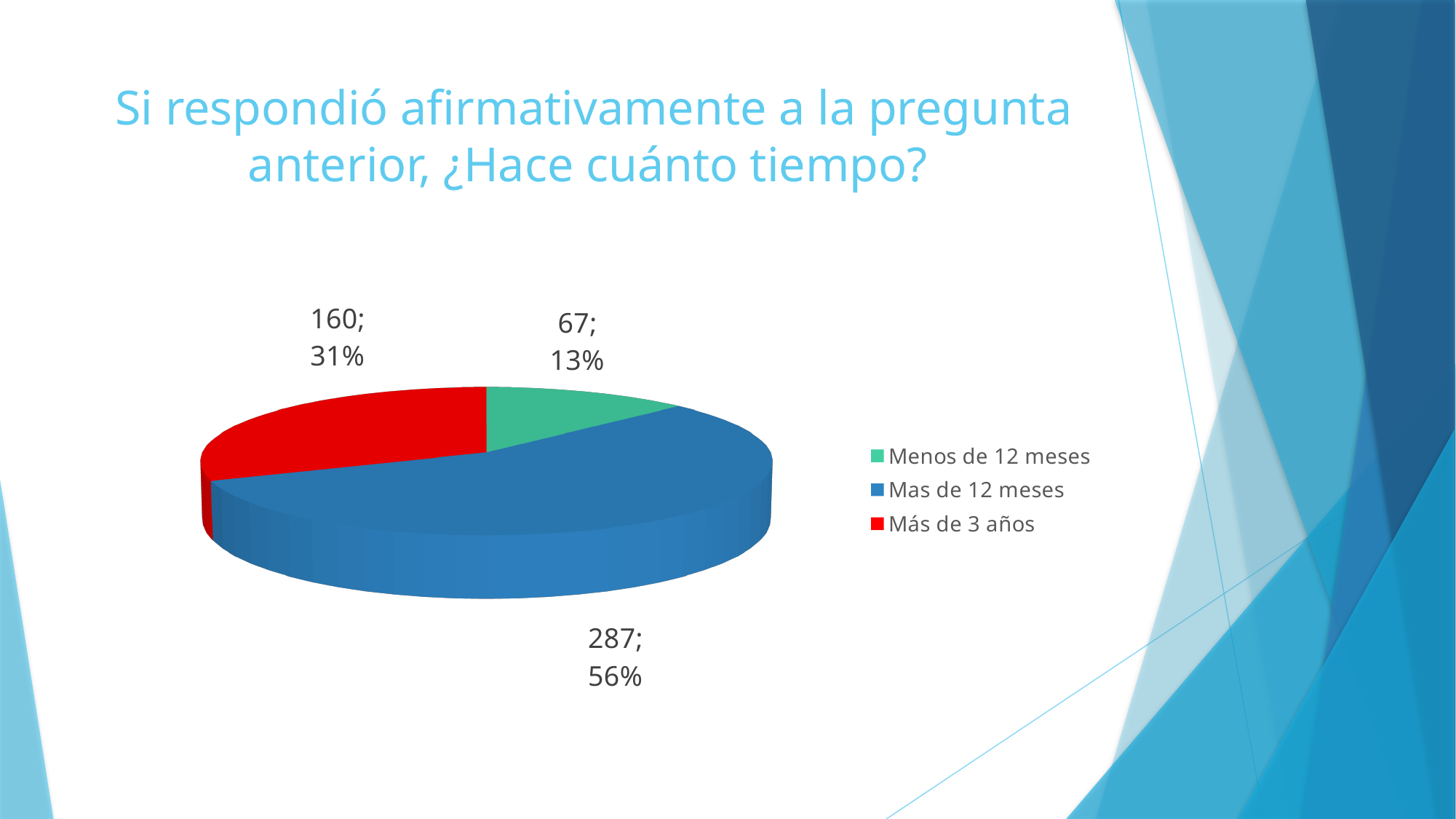
What is the value for 'Mas de 12 meses'? 287 How many entries does the legend list? 3 What is the value for 'Más de 3 años'? 160 What is the value for 'Menos de 12 meses'? 67 Which category has the smallest slice? Menos de 12 meses Which category has the largest slice? Mas de 12 meses What share of the pie does 'Menos de 12 meses' represent? 13% Which colour represents 'Más de 3 años' in the legend? red What is the difference between the values for 'Mas de 12 meses' and 'Más de 3 años'? 127 What kind of chart is shown on the slide? pie chart What share of the pie does 'Mas de 12 meses' represent? 56% How many slices does the pie chart have? 3